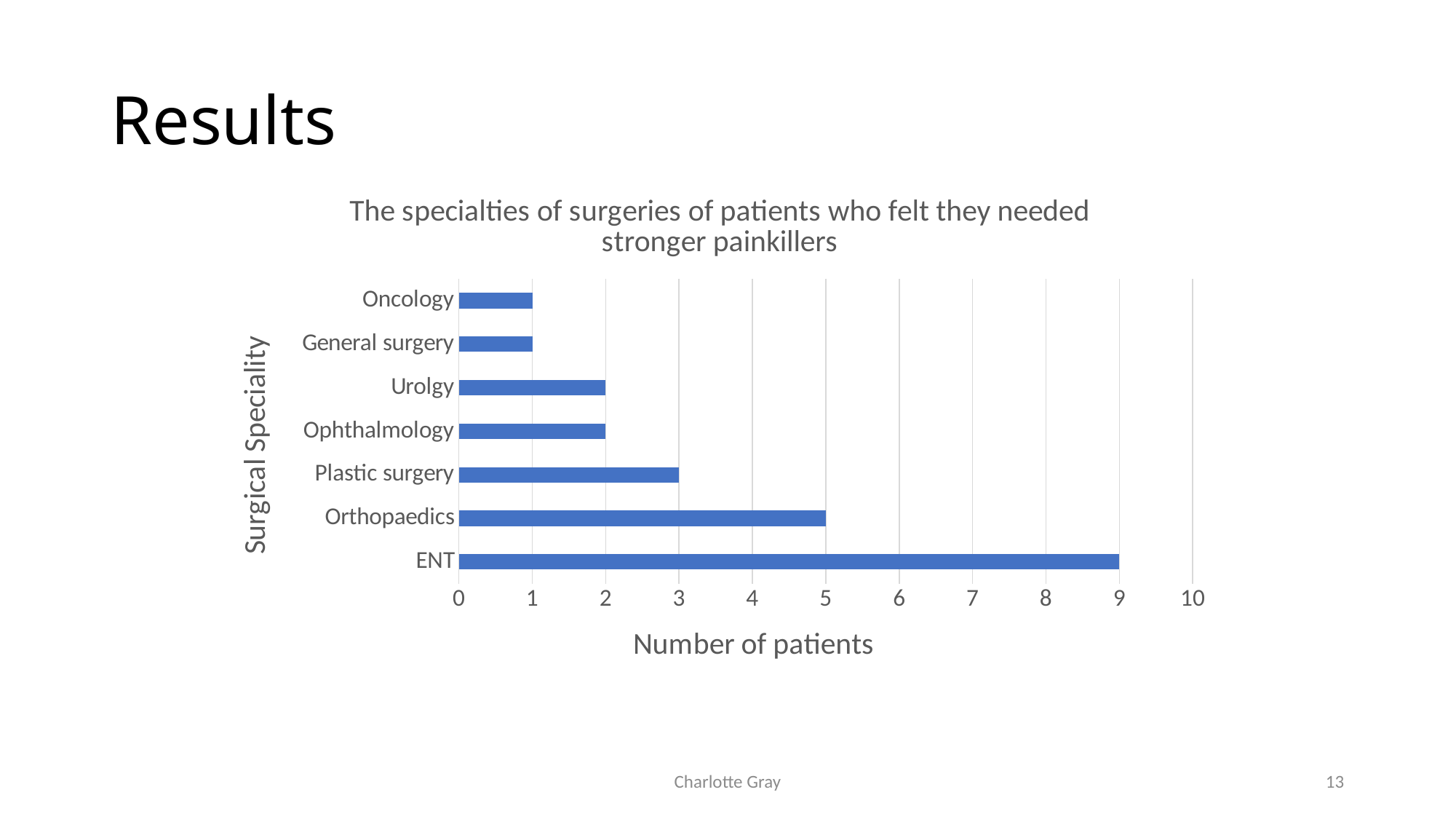
What is the number of patients for Orthopaedics? 5 What is the difference in number of patients between ENT and Orthopaedics? 4 What type of chart is shown on the slide? bar chart What is the label of the horizontal axis? Number of patients Which has more patients, Plastic surgery or Urolgy? Plastic surgery What is the number of patients for ENT? 9 Is the value for ENT greater or less than 8? greater What is the number of patients for Oncology? 1 What is the number of patients for Ophthalmology? 2 Which surgical speciality has the highest number of patients? ENT How many surgical specialities are shown in the chart? 7 What is the number of patients for Plastic surgery? 3